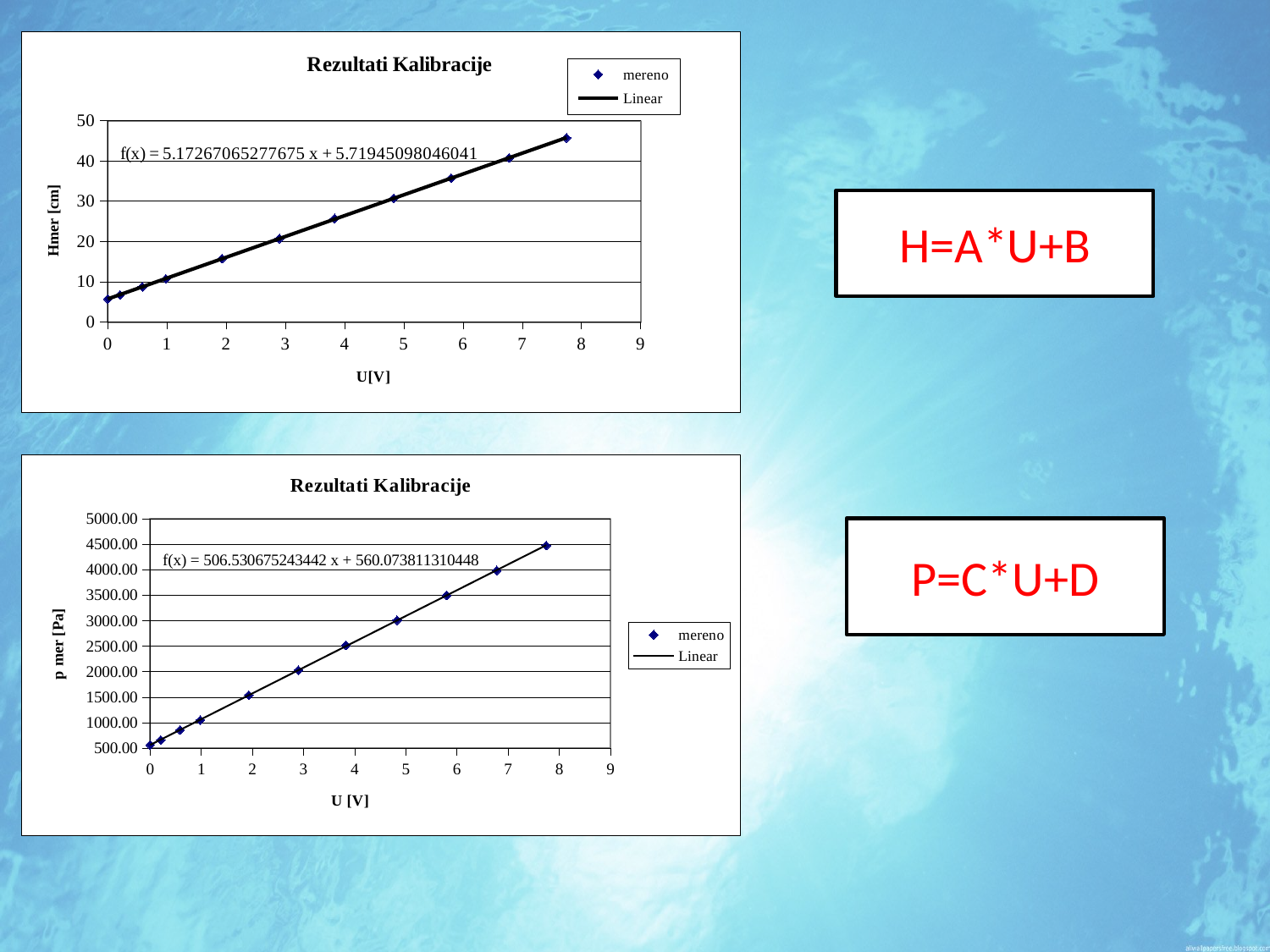
In the bottom chart (p mer [Pa]), is the value of the rightmost measured point greater or less than 4000.00? greater How many series does the legend of the bottom chart (p mer vs U) list? 2 In the bottom chart (p mer [Pa]), do the measured values rise or fall as U increases? rise In the top chart (Hmer [cm]), is the value of the measured point at U = 0 greater or less than 10? less What is the slope of the linear fit equation printed on the top chart (Hmer vs U)? 5.17267065277675 What is the y-axis label of the bottom chart? p mer [Pa] In the top chart (Hmer [cm]), which measured point has the larger value: the leftmost point or the rightmost point? the rightmost point What is the intercept of the linear fit equation printed on the bottom chart (p mer vs U)? 560.073811310448 In the bottom chart (p mer [Pa]), is the value of the measured point at U = 0 greater or less than 1000.00? less What kind of chart is the top chart titled 'Rezultati Kalibracije' (Hmer vs U)? scatter chart In the top chart (Hmer [cm]), do the measured values rise or fall as U increases? rise